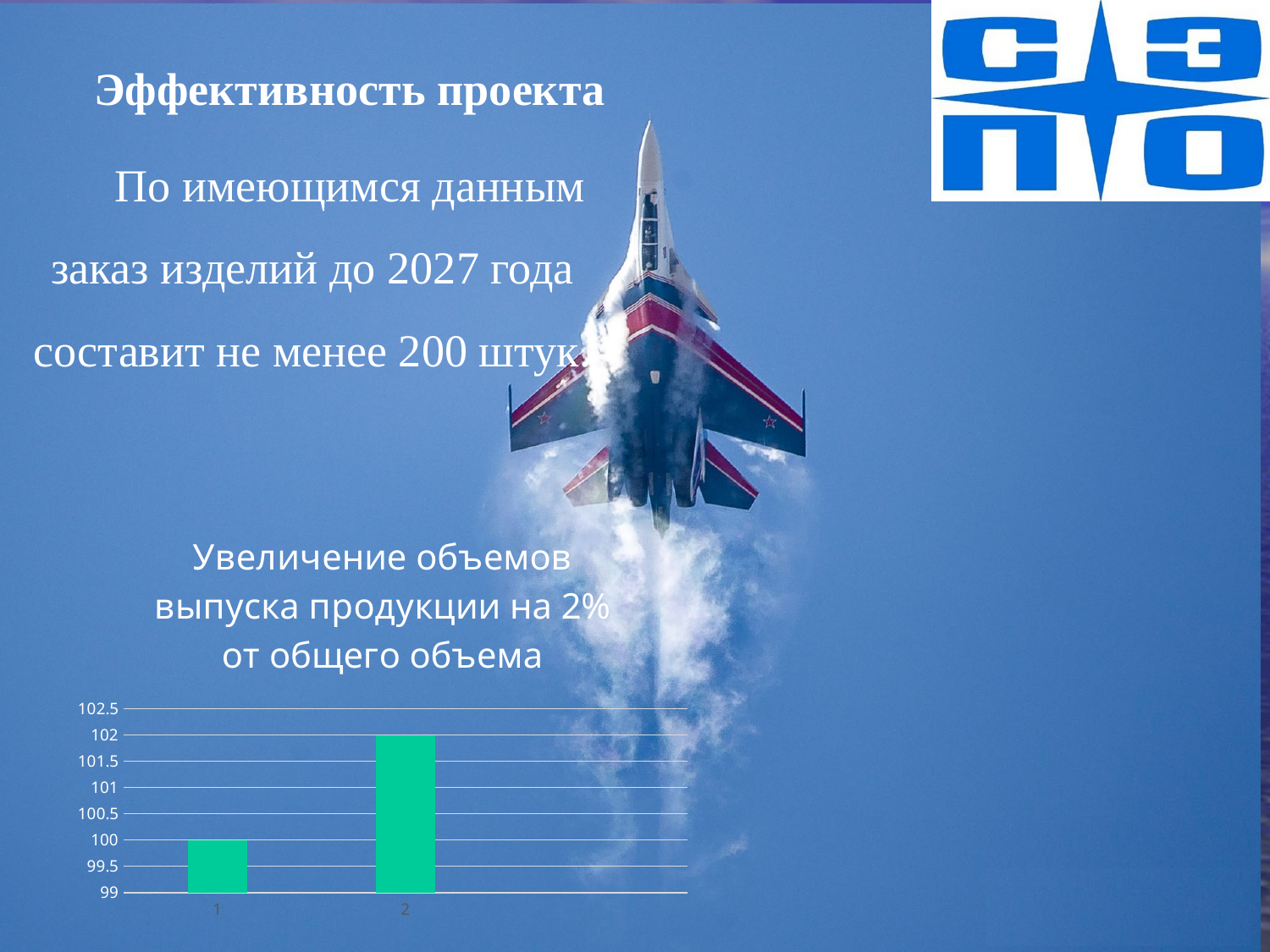
Which category has the lowest bar? 1 What is the value of the bar for category 2? 102 How many bars are plotted in the chart? 2 What is the highest value shown on the vertical axis of the chart? 102.5 What is the value of the bar for category 1? 100 What is the difference between the values for category 2 and category 1? 2 Do the bar values rise or fall from category 1 to category 2? rise What colour are the bars in the chart? green Which category has the highest bar? 2 What kind of chart is shown on the slide? bar chart Is the value for category 2 greater or less than 101? greater Which is larger, the value for category 1 or category 2? 2